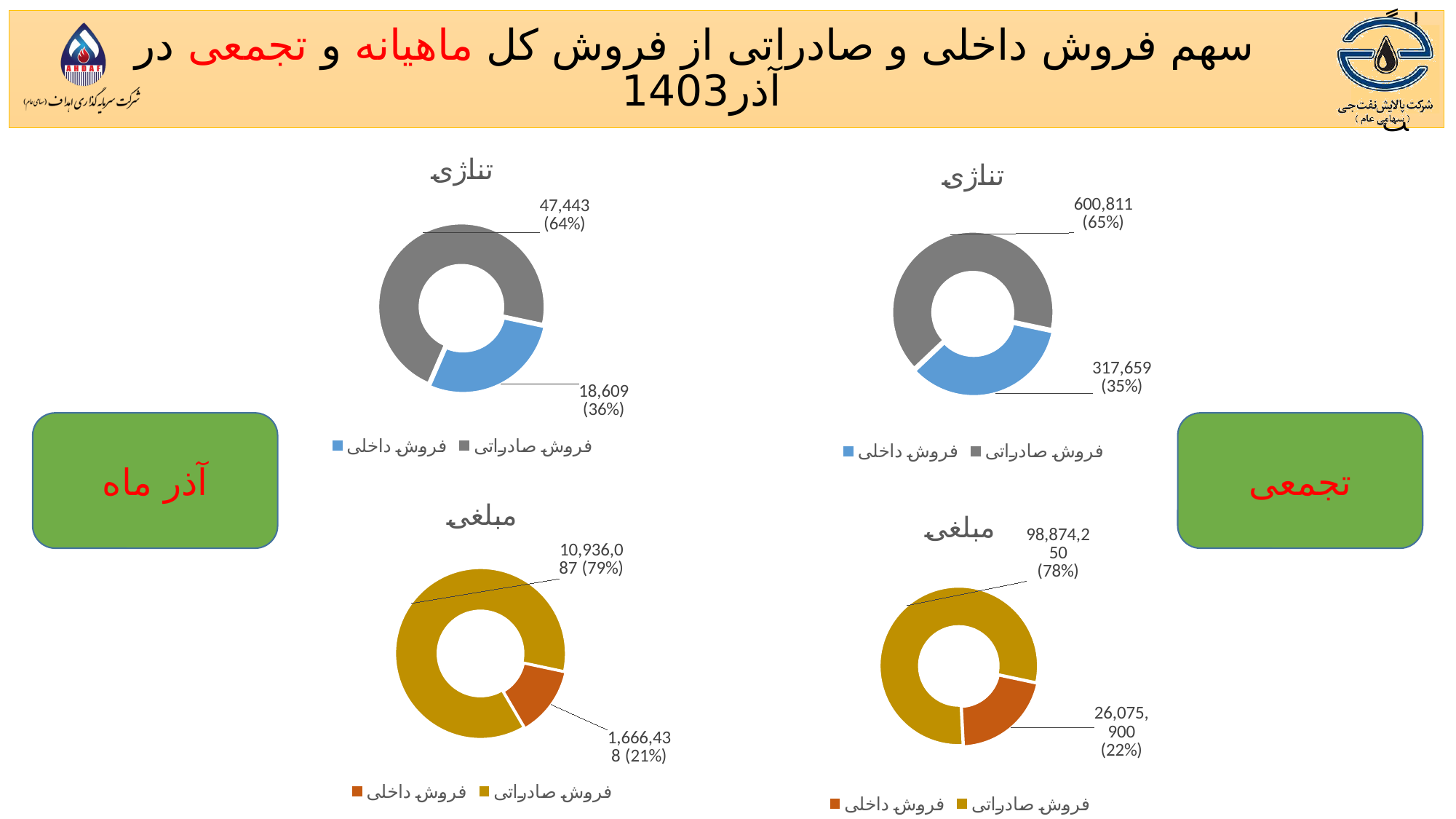
In the top-left donut chart (تناژی, آذر ماه), what is the value for فروش صادراتی? 47,443 In the bottom-left donut chart (مبلغی, آذر ماه), what share of the total does فروش صادراتی represent? 79% In the top-left donut chart (تناژی, آذر ماه), what share of the total does فروش داخلی represent? 36% In the top-right donut chart (تناژی, تجمعی), what is the value for فروش داخلی? 317,659 How many charts are shown on the slide? 4 In the bottom-right donut chart (مبلغی, تجمعی), what is the value for فروش صادراتی? 98,874,250 In the top-right donut chart (تناژی, تجمعی), what share of the total does فروش صادراتی represent? 65% What type of chart is used for the bottom-right chart (مبلغی, تجمعی)? Donut (pie) chart In the bottom-right donut chart (مبلغی, تجمعی), what is the value for فروش داخلی? 26,075,900 In the top-right donut chart (تناژی, تجمعی), what is the difference between فروش صادراتی and فروش داخلی? 283,152 In the bottom-left donut chart (مبلغی, آذر ماه), what is the value for فروش داخلی? 1,666,438 In the top-left donut chart (تناژی, آذر ماه), which category has the larger value, فروش صادراتی or فروش داخلی? فروش صادراتی